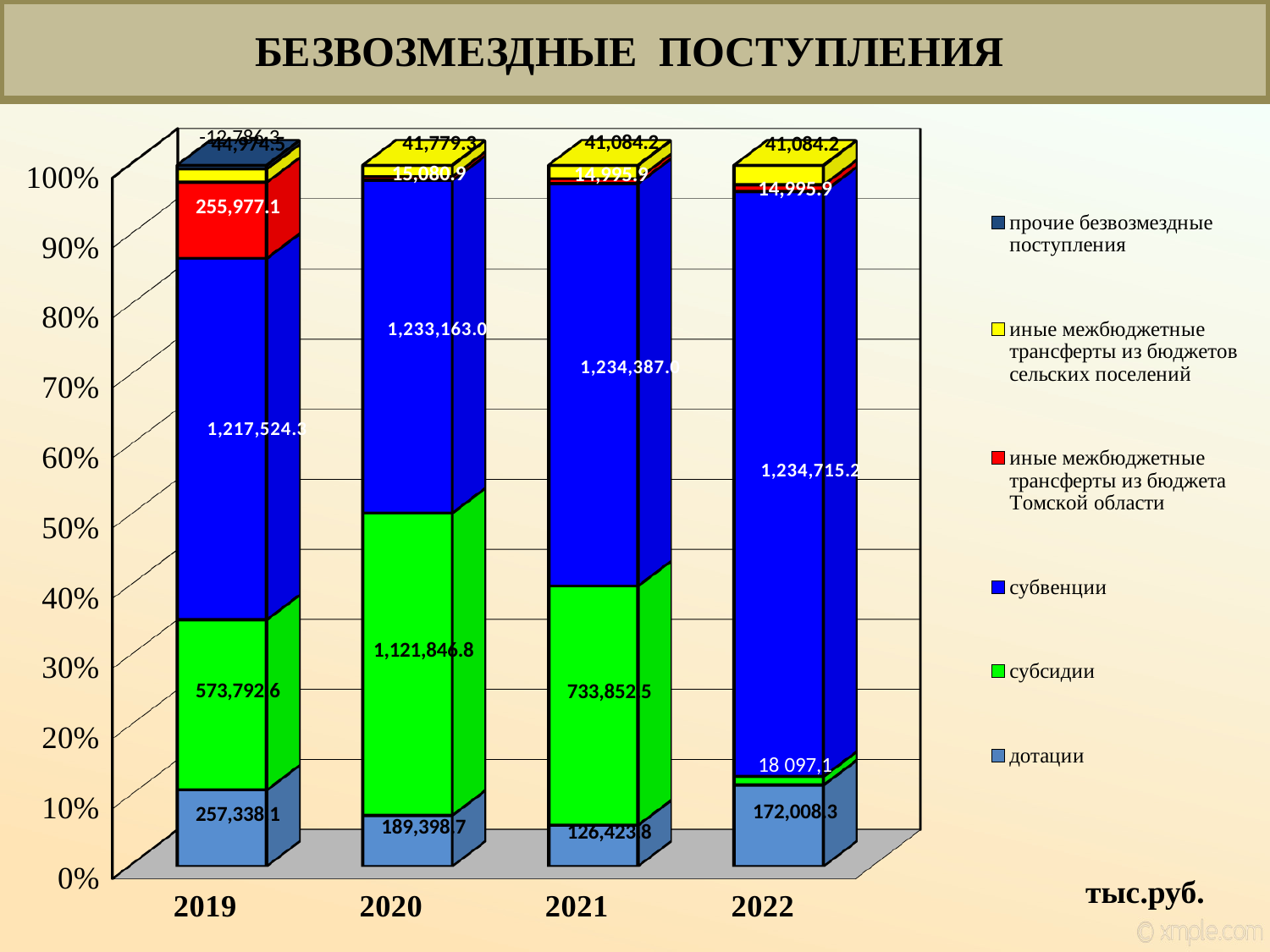
What is the value of дотации for 2022? 172,008.3 How many series does the legend list? 6 What is the value of иные межбюджетные трансферты из бюджета Томской области for 2019? 255,977.1 What is the value of субсидии for 2021? 733,852.5 In which year is the value of дотации the highest? 2019 What unit of measurement is stated on the slide for the chart values? тыс.руб. How many years (categories) are shown on the x axis? 4 Do the values of субвенции rise or fall from 2019 to 2022? rise What kind of chart is shown on the slide? bar chart In which year is the value of дотации the lowest? 2021 What is the difference between the субсидии values for 2020 and 2021? 387,994.3 What is the value of субвенции for 2020? 1,233,163.0